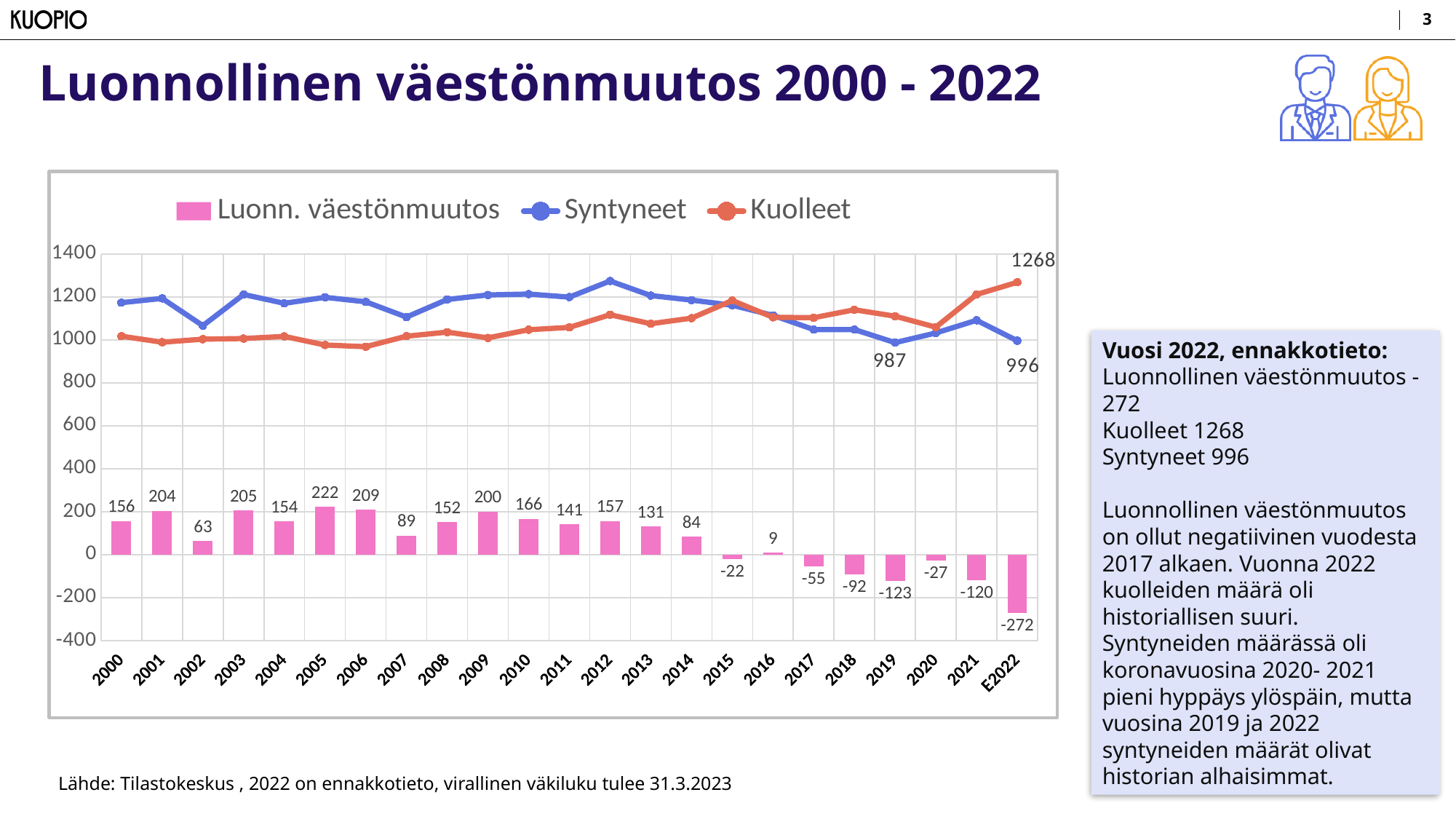
What is the value of Syntyneet for 2019? 987 How many series does the legend list? 3 Which year has the highest value of Luonn. väestönmuutos? 2005 Is the value of Syntyneet for 2012 greater or less than 1200? greater What is the value of Kuolleet for E2022? 1268 How many years are shown on the x axis? 23 What is the value of Luonn. väestönmuutos for 2005? 222 What kind of chart is this? Combined bar and line chart Which year has the lowest value of Luonn. väestönmuutos? E2022 What is the difference between Kuolleet and Syntyneet in E2022? 272 Which is larger, the Luonn. väestönmuutos value for 2001 or for 2003? 2003 What is the value of Luonn. väestönmuutos for 2019? -123